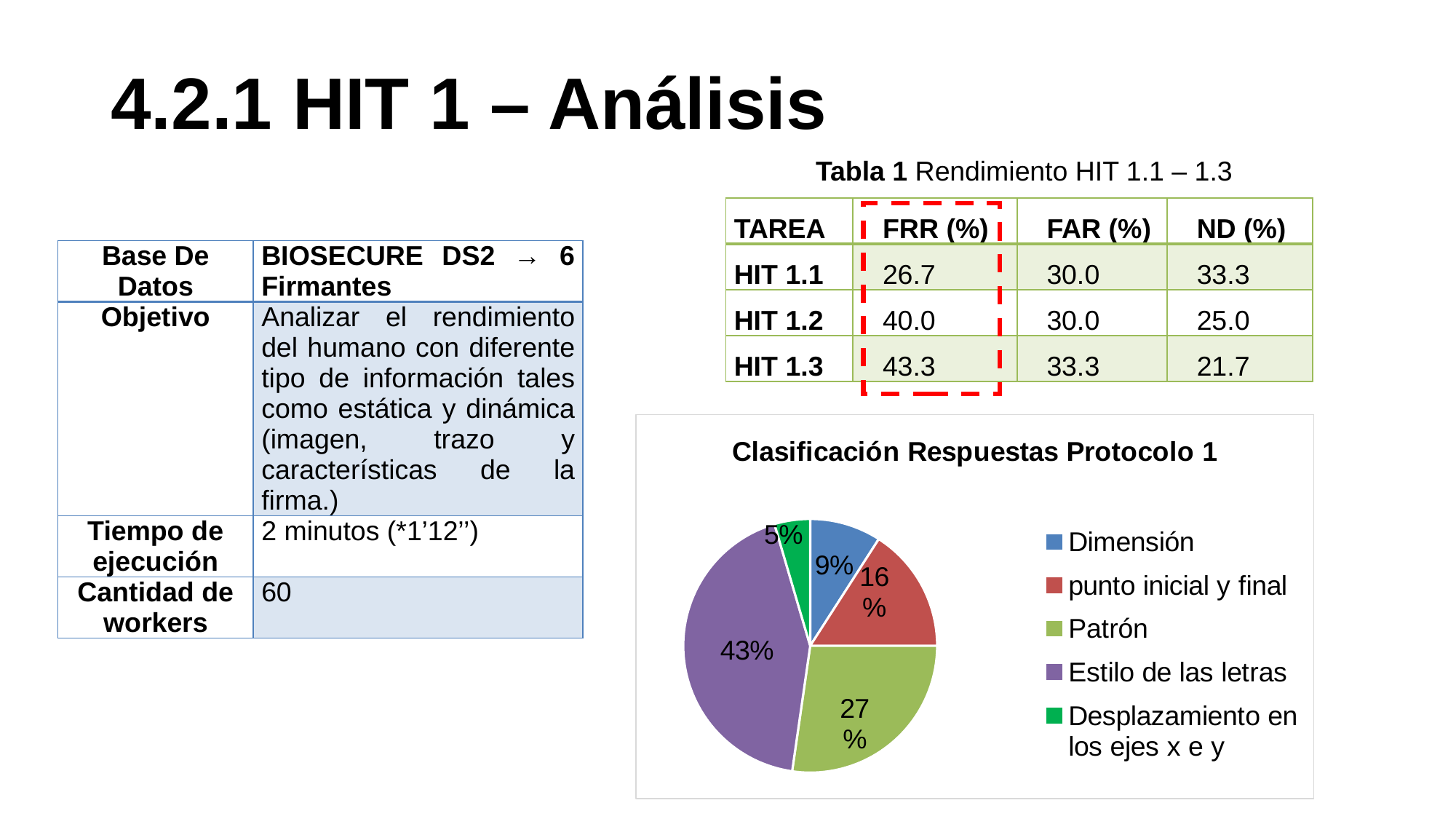
How many categories does the pie chart's legend list? 5 In the pie chart, which is larger: 'punto inicial y final' or 'Dimensión'? punto inicial y final In the pie chart, what share does 'Patrón' have? 27% Which category has the largest slice in the pie chart? Estilo de las letras In the pie chart, what share does 'punto inicial y final' have? 16% In the pie chart, what share does 'Desplazamiento en los ejes x e y' have? 5% What kind of chart is 'Clasificación Respuestas Protocolo 1'? pie chart What is the title of the pie chart? Clasificación Respuestas Protocolo 1 In the pie chart, what share does 'Dimensión' have? 9% In the pie chart, what is the difference between the shares of 'Estilo de las letras' and 'Patrón'? 16% In the pie chart, what share does 'Estilo de las letras' have? 43% Which category has the smallest slice in the pie chart? Desplazamiento en los ejes x e y